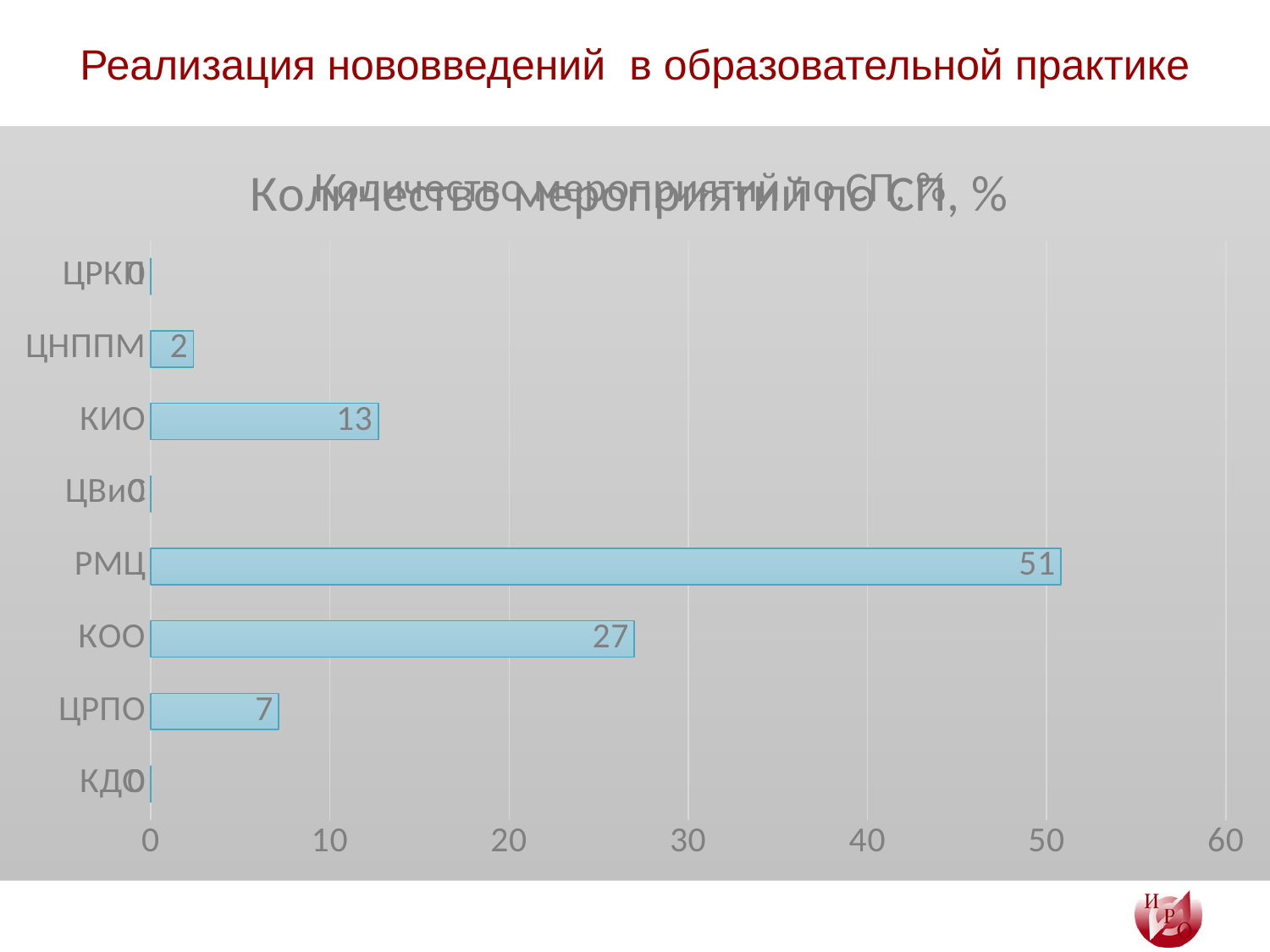
Which is larger, the value for КИО or the value for ЦРПО? КИО Which category has the highest value? РМЦ What is the title of the chart? Количество мероприятий по СП, % What is the value for РМЦ? 51 What is the difference between the values for РМЦ and КОО? 24 What is the value for ЦРПО? 7 What is the value for КОО? 27 What is the value for КИО? 13 Is the value for КОО greater or less than 30? less How many categories are shown on the chart? 8 What is the value for ЦНППМ? 2 What type of chart is shown on the slide? bar chart